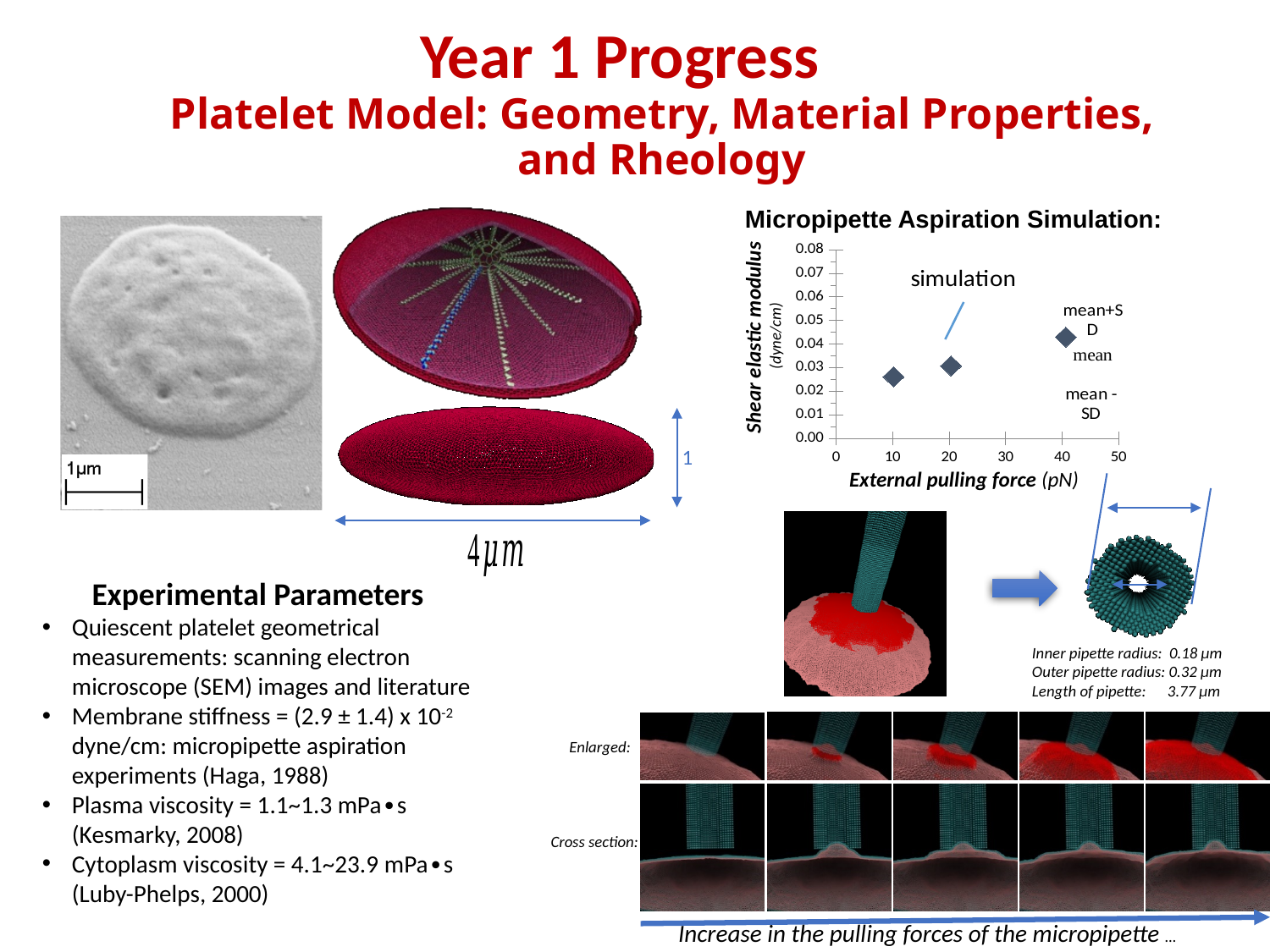
In the Micropipette Aspiration Simulation chart, which has the larger shear elastic modulus: the point at 40 pN or the point at 10 pN? 40 pN What is the y-axis label of the Micropipette Aspiration Simulation chart? Shear elastic modulus (dyne/cm) In the Micropipette Aspiration Simulation chart, is the shear elastic modulus at 40 pN greater or less than 0.03? greater What kind of chart is the Micropipette Aspiration Simulation chart? scatter chart In the Micropipette Aspiration Simulation chart, at which external pulling force is the shear elastic modulus highest? 40 pN In the Micropipette Aspiration Simulation chart, does the shear elastic modulus rise or fall as the external pulling force increases? rise In the Micropipette Aspiration Simulation chart, is the shear elastic modulus at 20 pN greater or less than 0.02? greater In the Micropipette Aspiration Simulation chart, at which external pulling force is the shear elastic modulus lowest? 10 pN In the Micropipette Aspiration Simulation chart, is the shear elastic modulus at 10 pN greater or less than 0.03? less How many data points are plotted in the Micropipette Aspiration Simulation chart? 3 What is the x-axis label of the Micropipette Aspiration Simulation chart? External pulling force (pN)